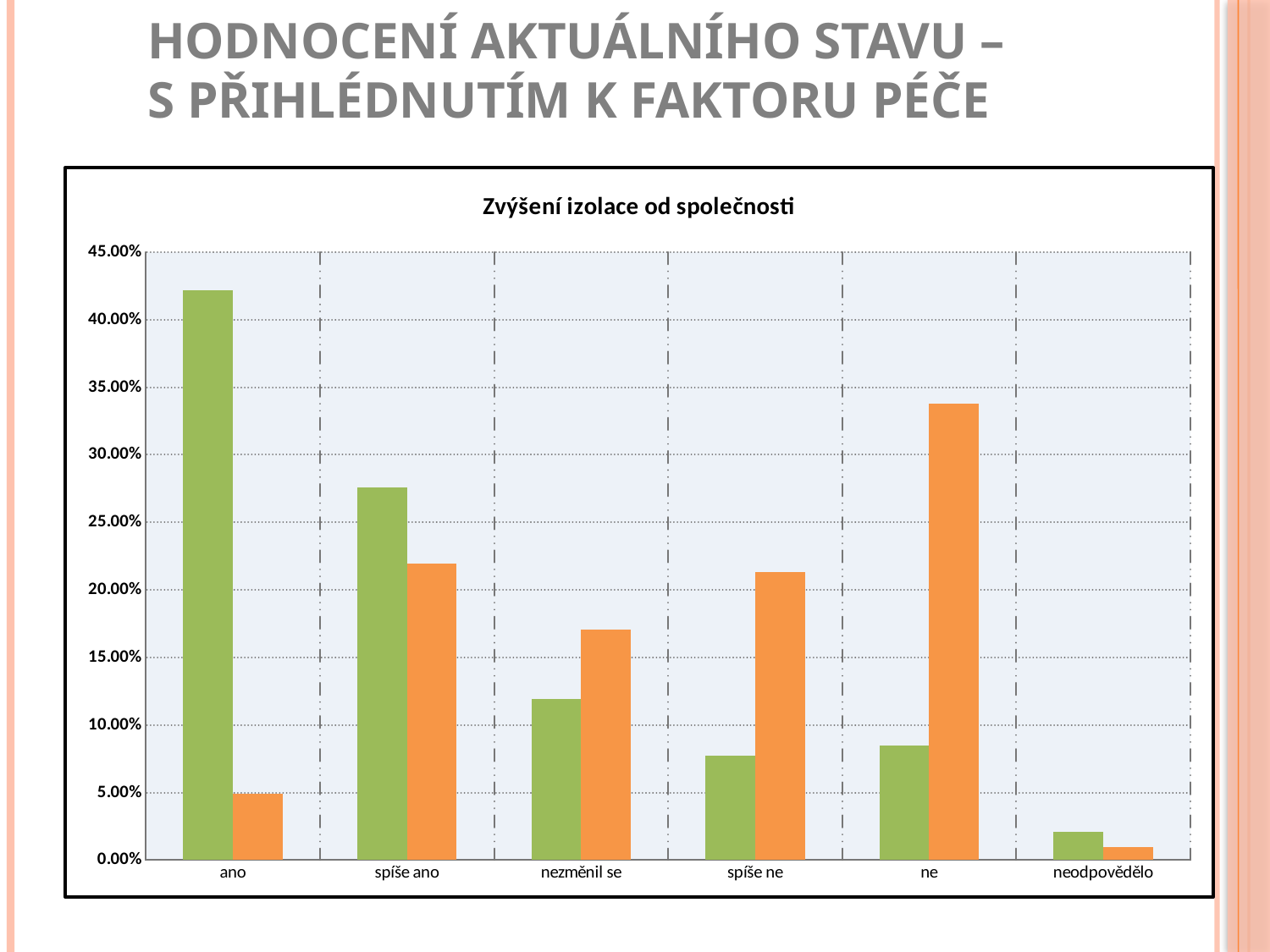
Is the green bar for 'ano' greater or less than 40.00%? greater Which category has the shortest orange bar? neodpovědělo Is the green bar for 'spíše ano' greater or less than 25.00%? greater Is the orange bar for 'ne' greater or less than 30.00%? greater What is the title of the chart? Zvýšení izolace od společnosti What kind of chart is shown on the slide? bar chart For the category 'ano', which bar is taller, the green one or the orange one? green How many categories are shown on the x axis of the chart? 6 Which category has the tallest orange bar? ne For the category 'ne', which bar is taller, the green one or the orange one? orange Which category has the tallest green bar? ano